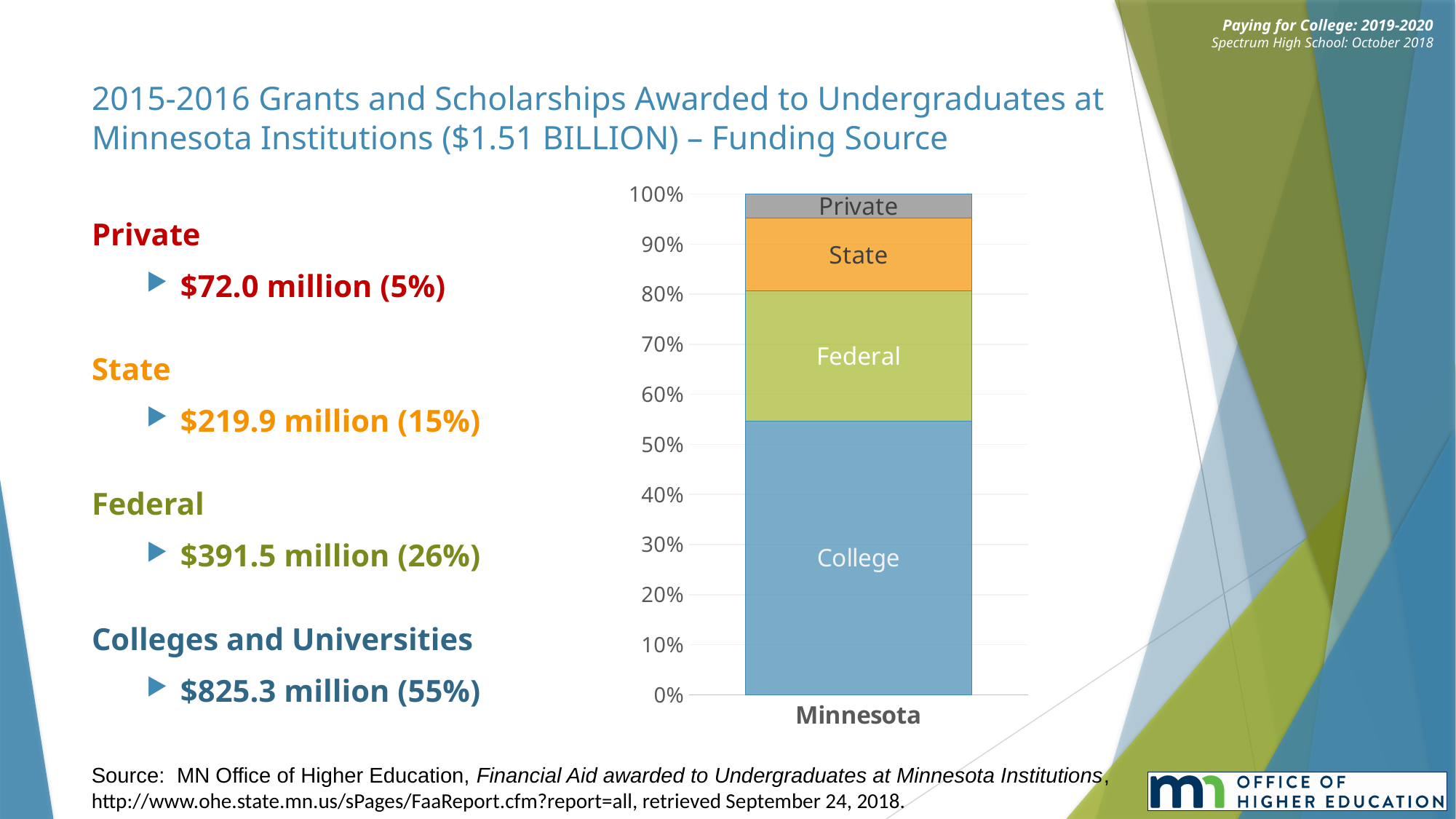
Which funding source is the largest segment of the stacked bar? College What is the category label on the x axis of the chart? Minnesota Which funding source is the smallest segment of the stacked bar? Private Which is larger, the Federal share or the State share? Federal What share of grants and scholarships came from State sources? 15% What kind of chart is shown on the slide? Stacked bar chart How many segments make up the stacked bar for Minnesota? 4 What dollar amount of grants and scholarships came from Private sources? $72.0 million What share of grants and scholarships came from Federal sources? 26% What dollar amount of grants and scholarships came from Colleges and Universities? $825.3 million Is the College segment's share greater or less than 50%? greater What is the difference in percentage points between the College share and the Federal share? 29 percentage points